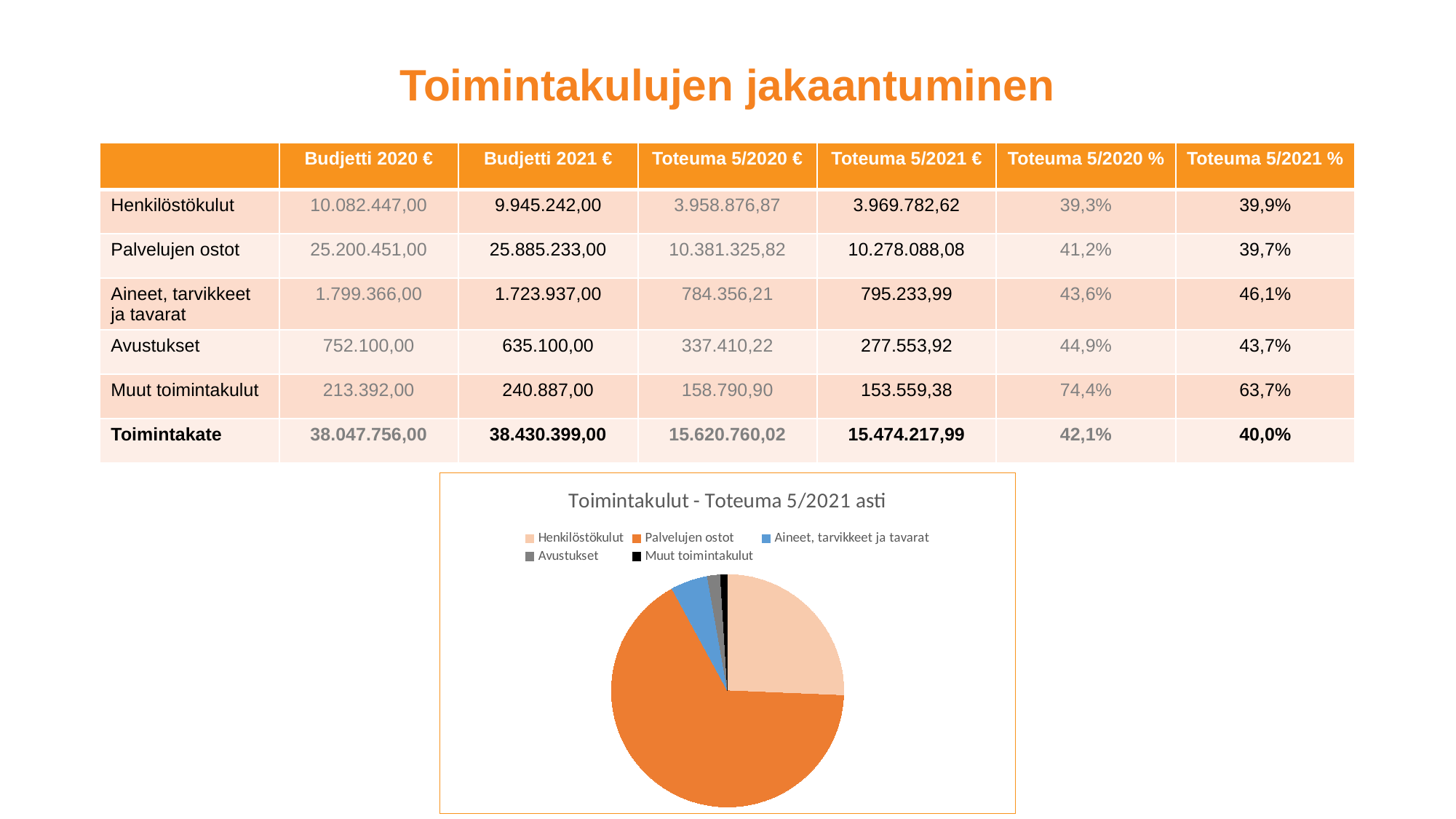
How many slices does the pie chart have? 5 In the pie chart, which slice is larger: Palvelujen ostot or Henkilöstökulut? Palvelujen ostot According to the table, what is the Toteuma 5/2021 € value for Palvelujen ostot, the largest slice of the pie chart? 10.278.088,08 What colour is the Palvelujen ostot slice in the pie chart? orange In the pie chart, which slice is larger: Aineet, tarvikkeet ja tavarat or Avustukset? Aineet, tarvikkeet ja tavarat According to the table, what is the Toteuma 5/2021 € value for Muut toimintakulut, the smallest slice of the pie chart? 153.559,38 Which category has the largest slice in the pie chart? Palvelujen ostot What kind of chart is shown on the slide? pie chart What is the title of the pie chart? Toimintakulut - Toteuma 5/2021 asti How many entries does the pie chart's legend list? 5 Which category has the smallest slice in the pie chart? Muut toimintakulut In the pie chart, which slice is larger: Henkilöstökulut or Aineet, tarvikkeet ja tavarat? Henkilöstökulut